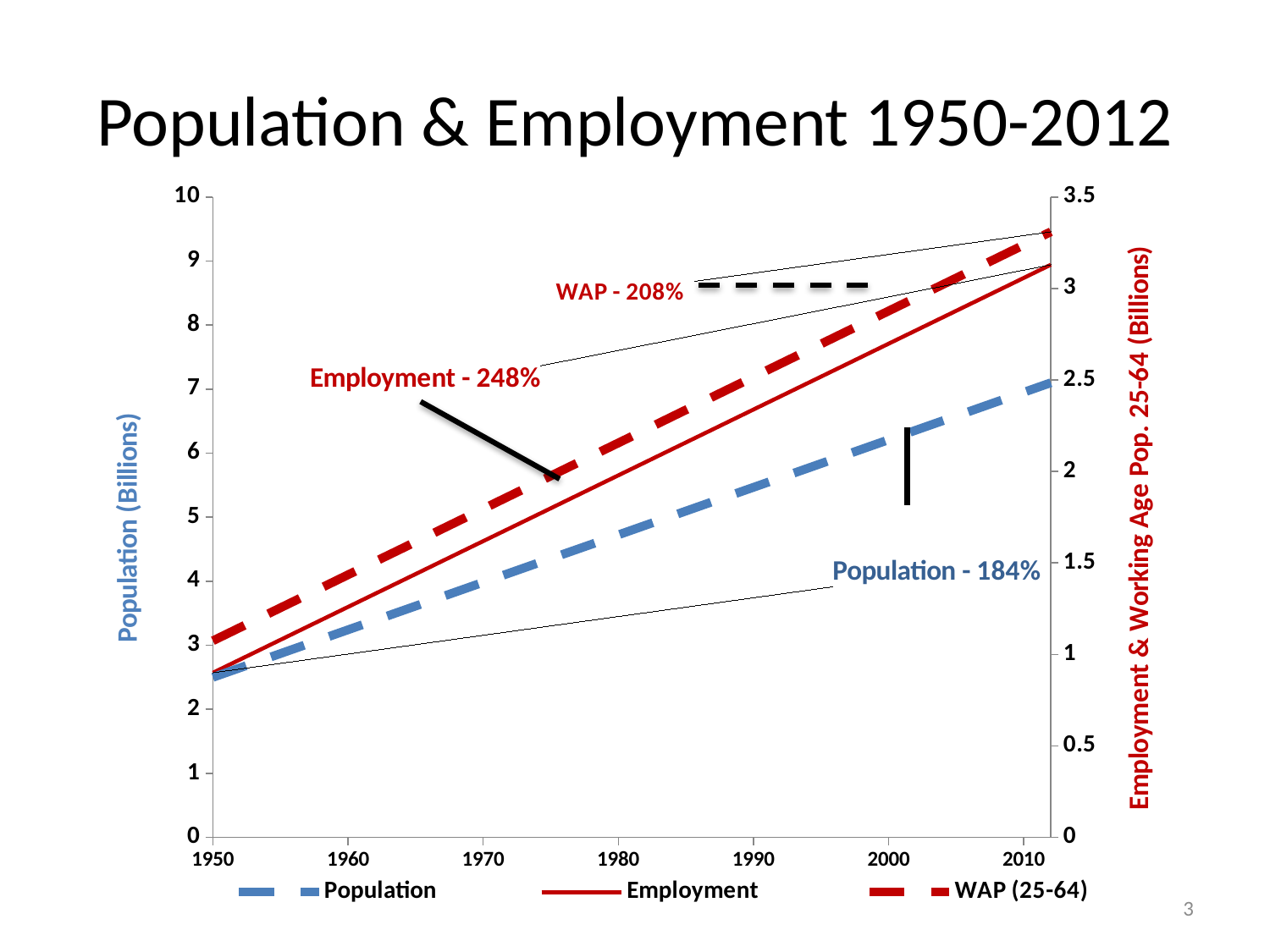
What growth percentage is annotated for Population? 184% Does the Population line rise or fall from 1950 to 2012? rise What growth percentage is annotated for WAP? 208% What is the label of the right-hand vertical axis? Employment & Working Age Pop. 25-64 (Billions) What is the title of the chart? Population & Employment 1950-2012 What growth percentage is annotated for Employment? 248% Is the Population value in 2010 greater or less than 6 billion on the left axis? greater How many series does the legend list? 3 Which series has the smallest annotated growth percentage? Population What kind of chart is shown on the slide? line chart Is the Employment value in 1950 greater or less than 1 on the right axis? less Which series has the largest annotated growth percentage? Employment